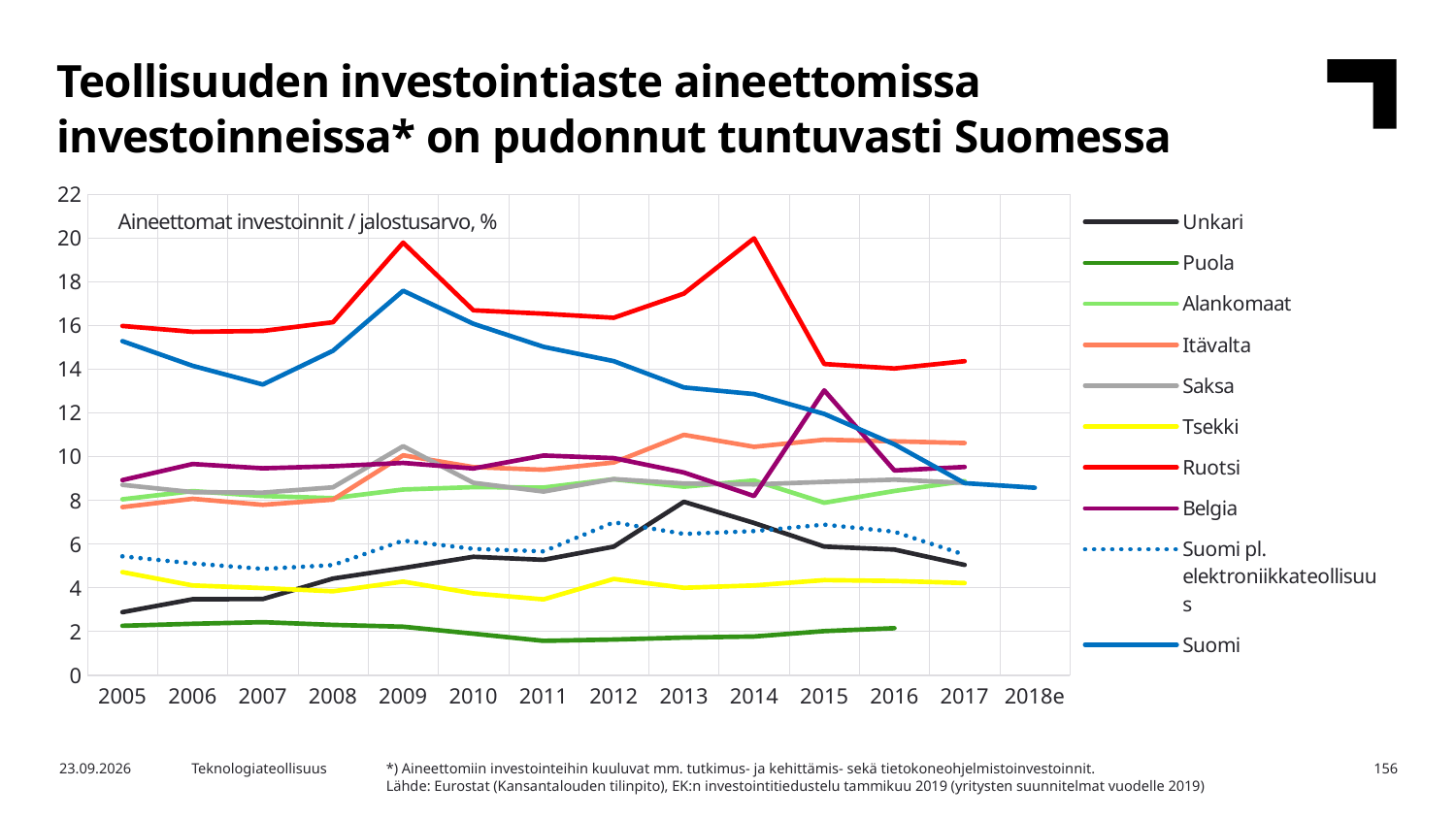
Does the value for Suomi rise or fall from 2009 to 2018e? fall Which series has the highest value in 2014? Ruotsi Is the value for Suomi in 2009 greater or less than 16? greater How many series does the legend list? 10 Is the value for Puola in 2005 greater or less than 4? less How many years are shown on the x axis? 14 Which series is drawn with a dotted line? Suomi pl. elektroniikkateollisuus Which series has the lowest value in 2011? Puola What kind of chart is shown on the slide? line chart Is the value for Suomi in 2018e greater or less than 10? less Which is larger in 2010, the value for Suomi or the value for Ruotsi? Ruotsi